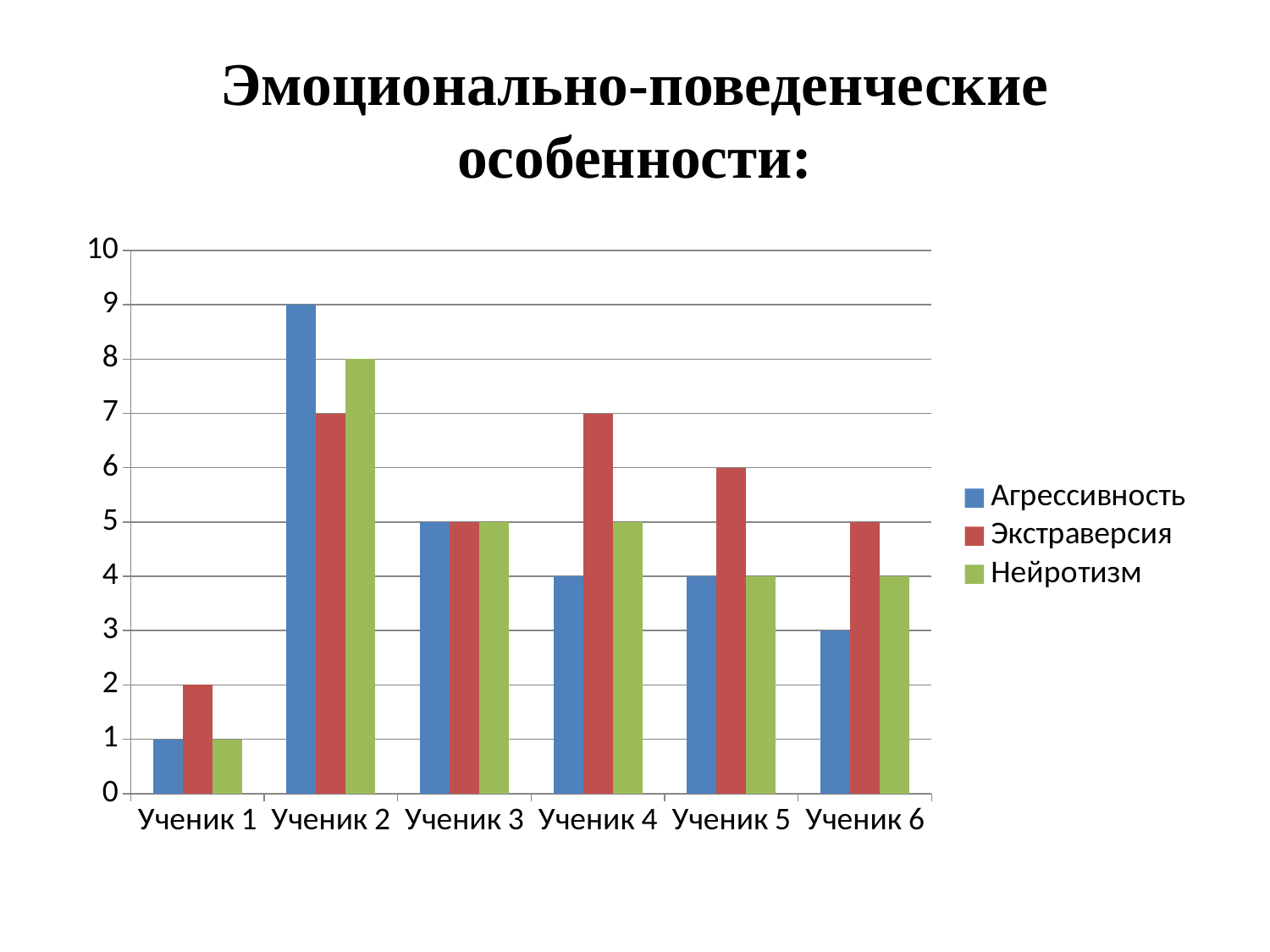
How many series does the legend list? 3 Which student has the highest Агрессивность value? Ученик 2 What type of chart is shown on the slide? bar chart Which student has the lowest Экстраверсия value? Ученик 1 What is the title of the chart on the slide? Эмоционально-поведенческие особенности: How many categories (students) are shown on the x axis? 6 What is the value of Экстраверсия for Ученик 4? 7 Which is larger for Ученик 5: Экстраверсия or Агрессивность? Экстраверсия What is the value of Агрессивность for Ученик 2? 9 What is the value of Нейротизм for Ученик 6? 4 Is the Агрессивность value for Ученик 2 greater or less than 8? greater What is the difference between the Нейротизм values for Ученик 2 and Ученик 1? 7